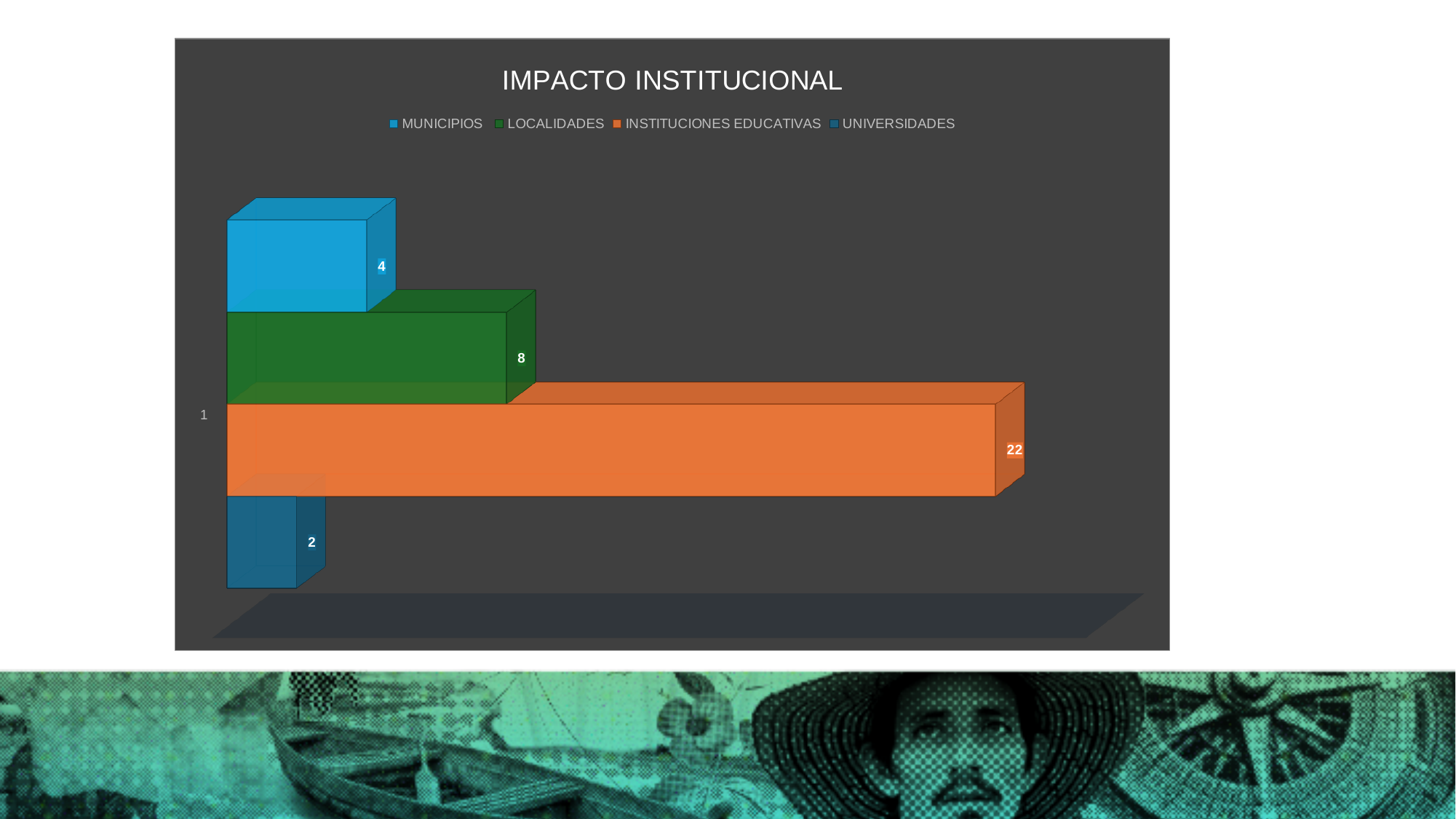
What is the value for LOCALIDADES? 8 What kind of chart is shown on the slide? Bar chart What is the title of the chart? IMPACTO INSTITUCIONAL What is the value for INSTITUCIONES EDUCATIVAS? 22 Which series has the lowest value? UNIVERSIDADES What is the value for UNIVERSIDADES? 2 How many series does the legend list? 4 Which series has the highest value? INSTITUCIONES EDUCATIVAS What is the value for MUNICIPIOS? 4 Which is larger, the value for LOCALIDADES or the value for MUNICIPIOS? LOCALIDADES What is the difference between the values for INSTITUCIONES EDUCATIVAS and LOCALIDADES? 14 What is the difference between the values for MUNICIPIOS and UNIVERSIDADES? 2